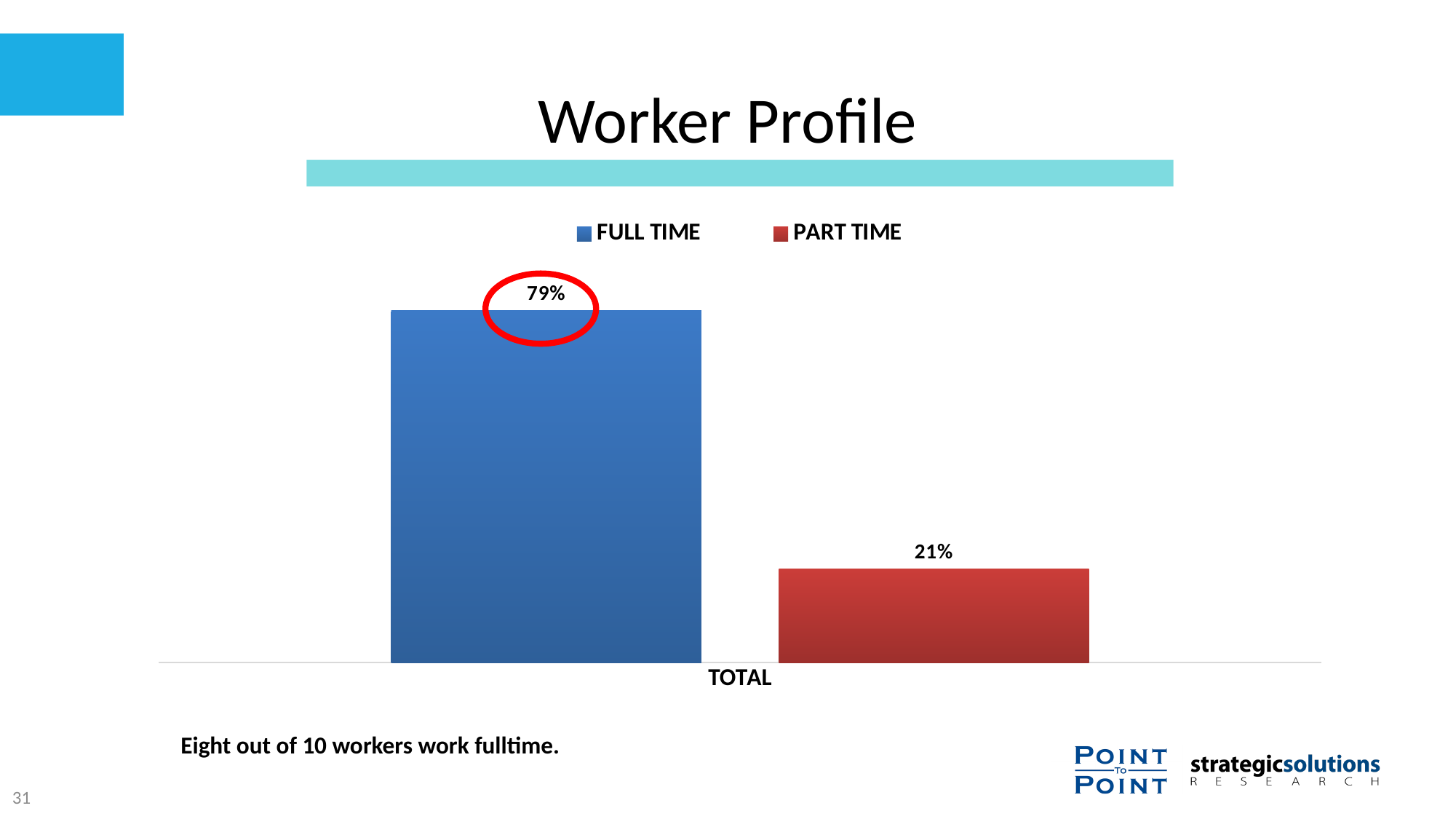
What is the title of the slide containing the chart? Worker Profile Is the FULL TIME value larger or smaller than the PART TIME value? larger What is the value for PART TIME in the TOTAL category? 21% What kind of chart is shown on the slide? bar chart What is the difference between the FULL TIME and PART TIME values? 58% Which series has the lower value, FULL TIME or PART TIME? PART TIME What is the value for FULL TIME in the TOTAL category? 79% Which series is shown in red? PART TIME Which series has the higher value, FULL TIME or PART TIME? FULL TIME How many categories are shown on the x axis? 1 How many series does the legend list? 2 What is the label of the category on the x axis? TOTAL